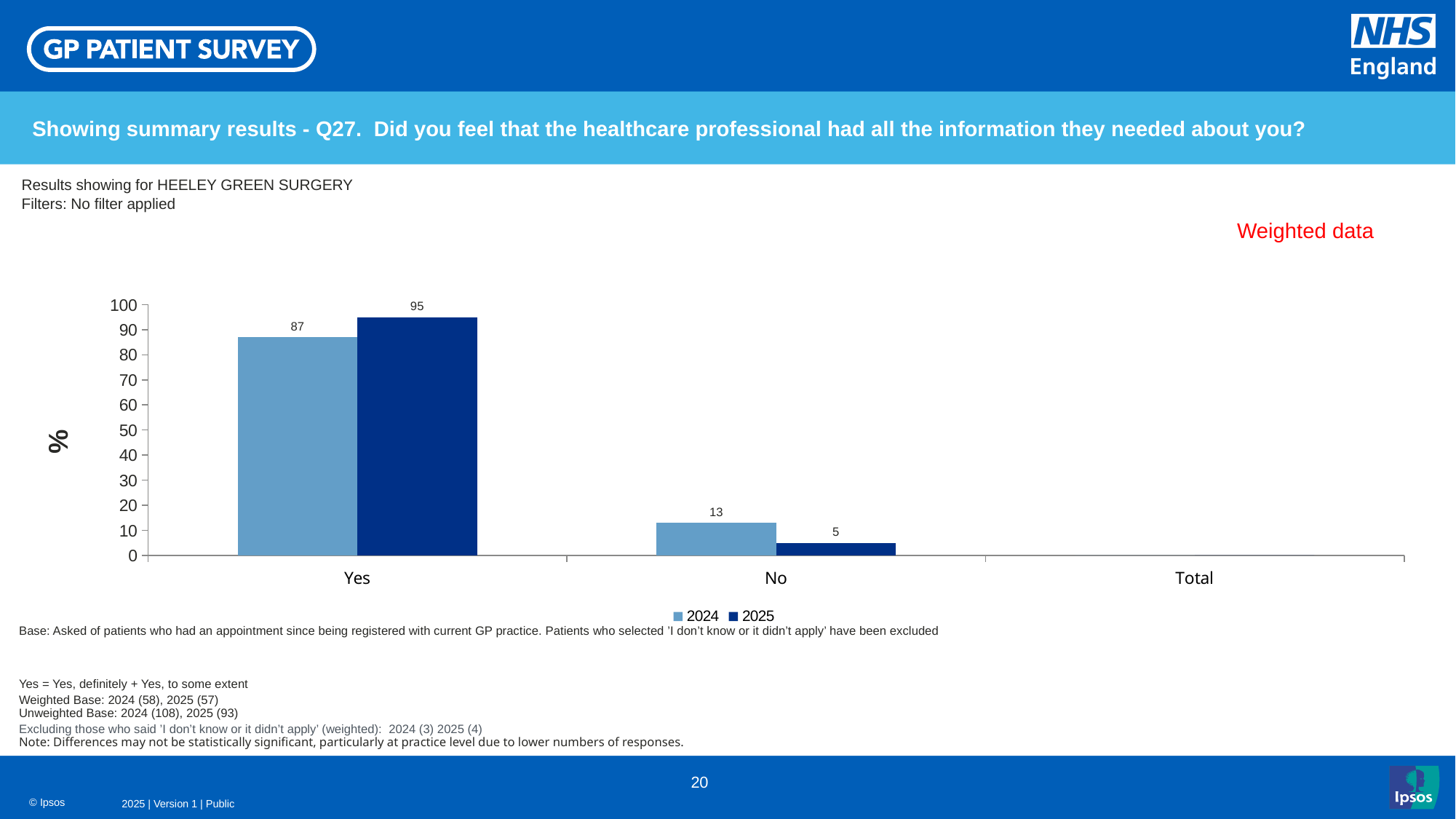
What is the difference between the 2025 and 2024 values for 'Yes'? 8 How many series does the legend list? 2 What is the value for 'No' in 2025? 5 What is the value for 'No' in 2024? 13 What kind of chart is shown on the slide? Bar chart Which category has the highest value in the 2025 series? Yes What is the difference between the 2024 and 2025 values for 'No'? 8 Which category has the lowest value in the 2024 series? No Which is larger: the 2024 value for 'Yes' or the 2025 value for 'Yes'? 2025 What is the value for 'Yes' in 2025? 95 What label is shown on the vertical axis of the chart? % What is the value for 'Yes' in 2024? 87